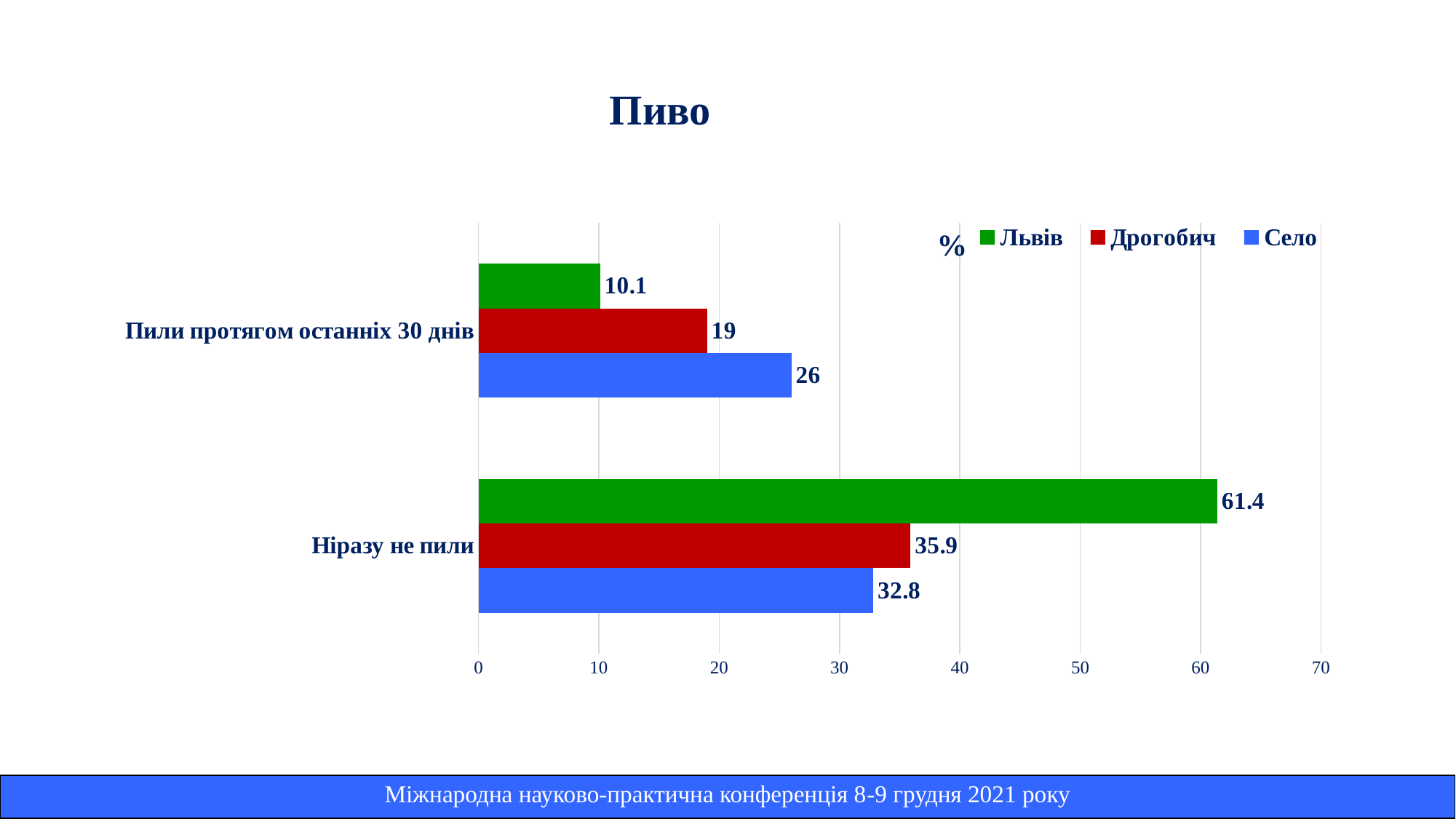
Is the value for Львів in the category "Ніразу не пили" greater or less than 60? greater What is the value for Село in the category "Пили протягом останніх 30 днів"? 26 What is the value for Дрогобич in the category "Ніразу не пили"? 35.9 What kind of chart is shown on the slide? bar chart Which is larger: the Дрогобич value or the Село value in the category "Ніразу не пили"? Дрогобич Which series has the lowest value in the category "Пили протягом останніх 30 днів"? Львів Which series has the highest value in the category "Ніразу не пили"? Львів What is the value for Львів in the category "Пили протягом останніх 30 днів"? 10.1 How many series does the legend list? 3 What is the difference between the Село and Львів values in the category "Пили протягом останніх 30 днів"? 15.9 How many categories are shown on the chart? 2 What is the title of the chart? Пиво